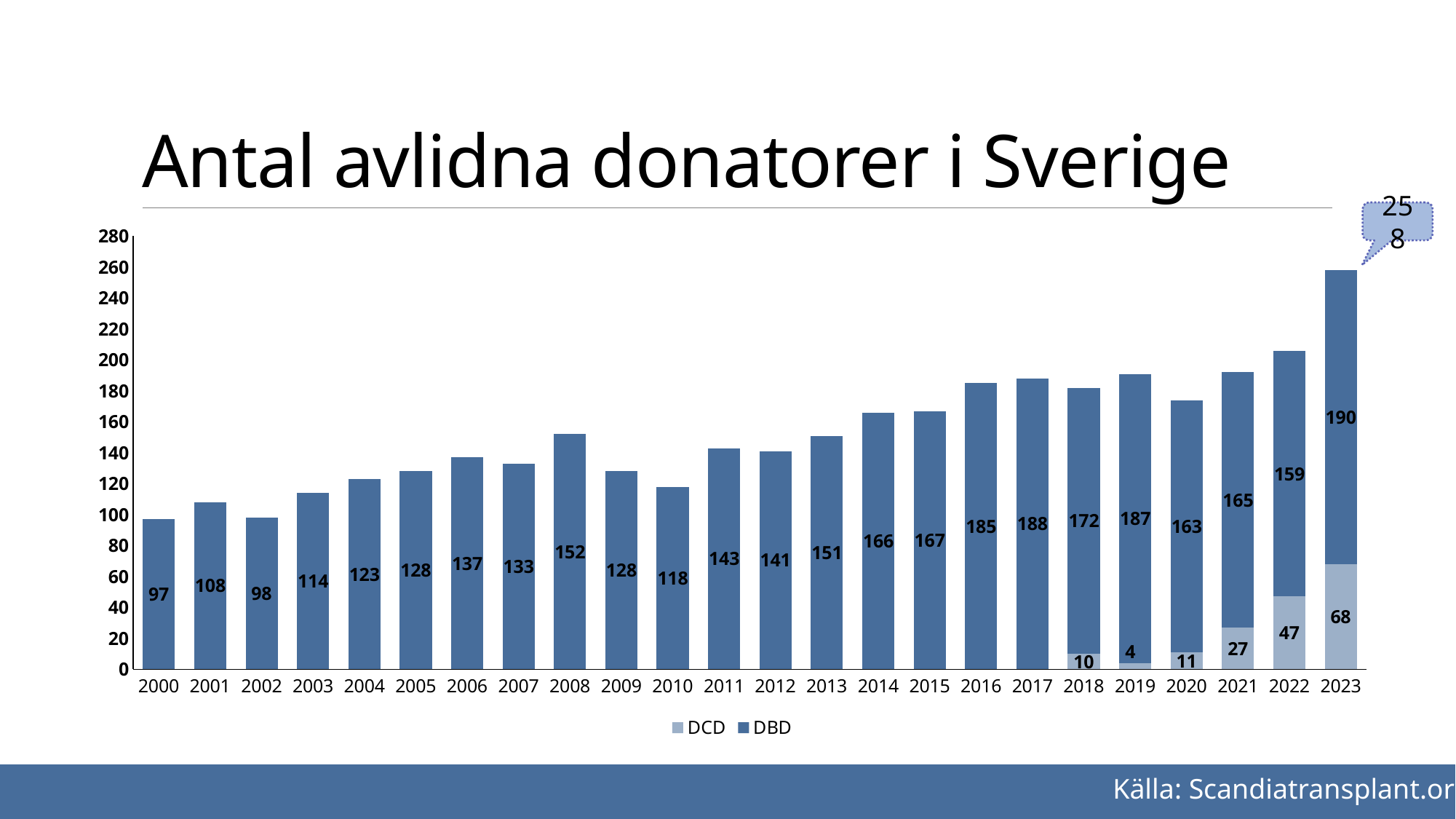
What is the total of the stacked bar for 2022? 206 Which year has the highest DBD value? 2023 How many series does the legend list? 2 What is the difference between the DBD values for 2017 and 2016? 3 Which year has the larger DCD value, 2020 or 2021? 2021 What is the DCD value for 2022? 47 What are the two series named in the legend? DCD and DBD What is the DBD value for 2008? 152 What kind of chart is shown on the slide? Stacked bar chart Which year has the lowest DBD value? 2000 What is the total of the stacked bar for 2023? 258 How many years are shown on the x axis? 24